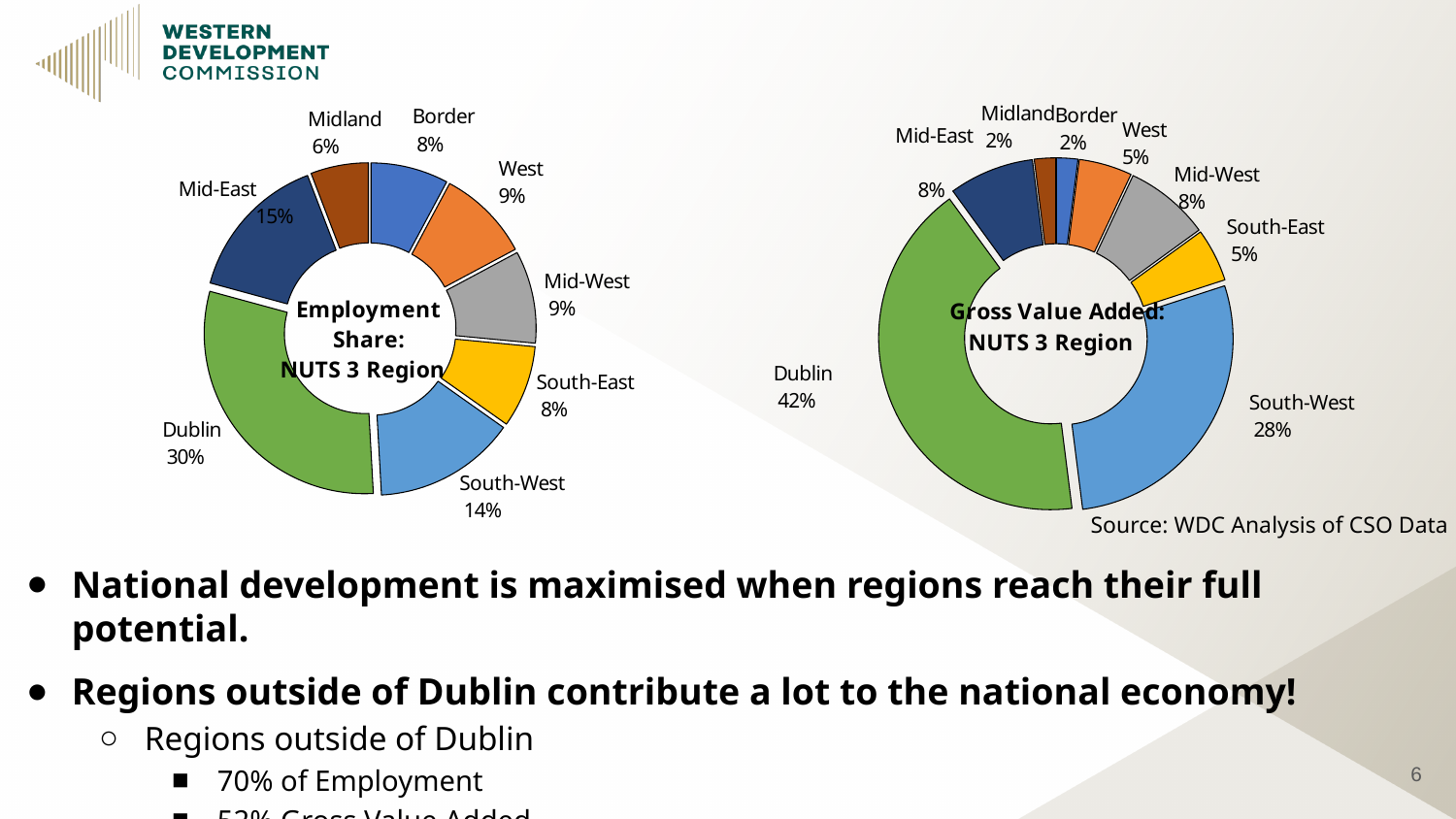
In the Gross Value Added: NUTS 3 Region chart, what is the share for South-West? 28% In the Employment Share: NUTS 3 Region chart, what is the share for Mid-East? 15% In the Gross Value Added: NUTS 3 Region chart, which is larger, the share for Mid-West or the share for West? Mid-West How many regions are shown in the Employment Share: NUTS 3 Region chart? 8 What is the source cited below the Gross Value Added: NUTS 3 Region chart? WDC Analysis of CSO Data In the Employment Share: NUTS 3 Region chart, what is the difference between Dublin's share and South-West's share? 16% In the Employment Share: NUTS 3 Region chart, which region has the smallest share? Midland In the Gross Value Added: NUTS 3 Region chart, what is the share for Dublin? 42% In the Gross Value Added: NUTS 3 Region chart, which region has the largest share? Dublin In the Employment Share: NUTS 3 Region chart, what is the share for Dublin? 30% What type of chart is the Gross Value Added: NUTS 3 Region chart? Doughnut chart In the Gross Value Added: NUTS 3 Region chart, what is the difference between Dublin's share and South-West's share? 14%